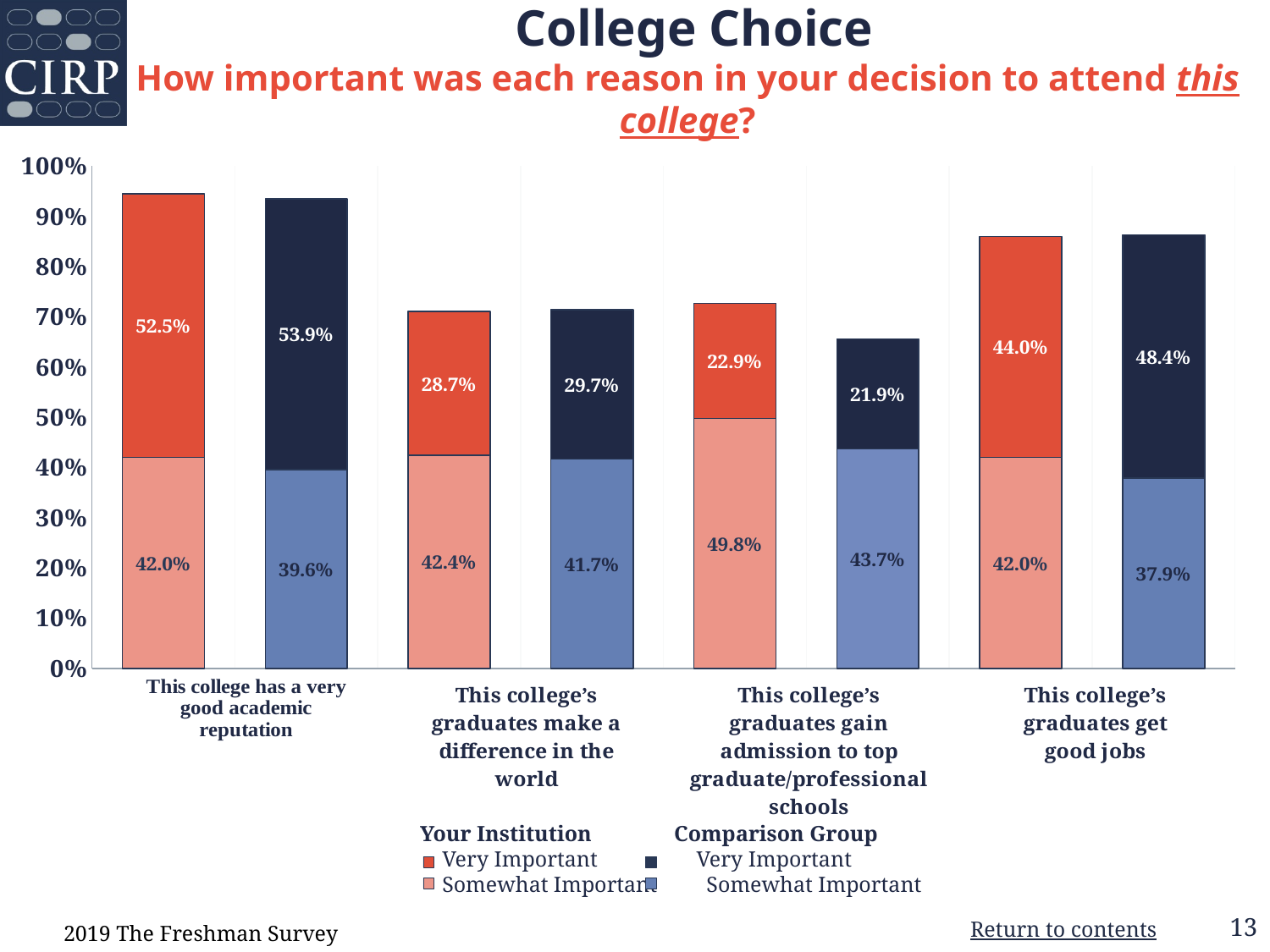
How many reasons (categories) are shown on the x axis of the chart? 4 What percentage of the Comparison Group rated "This college's graduates get good jobs" as Somewhat Important? 37.9% What is the combined Very Important and Somewhat Important percentage for the Comparison Group on "This college has a very good academic reputation"? 93.5% For "This college's graduates gain admission to top graduate/professional schools", which group has the larger Somewhat Important percentage, Your Institution or the Comparison Group? Your Institution What type of chart is shown on the slide? Stacked bar chart What is the difference between the Comparison Group and Your Institution Very Important percentages for "This college's graduates get good jobs"? 4.4% Which reason has the lowest Very Important percentage for Your Institution? This college's graduates gain admission to top graduate/professional schools Which reason has the highest Very Important percentage for the Comparison Group? This college has a very good academic reputation How many series does the chart legend list? 4 What percentage of Your Institution students rated "This college has a very good academic reputation" as Very Important? 52.5% What is the combined Very Important and Somewhat Important percentage for Your Institution on "This college's graduates get good jobs"? 86.0% What percentage of Your Institution students rated "This college's graduates gain admission to top graduate/professional schools" as Somewhat Important? 49.8%